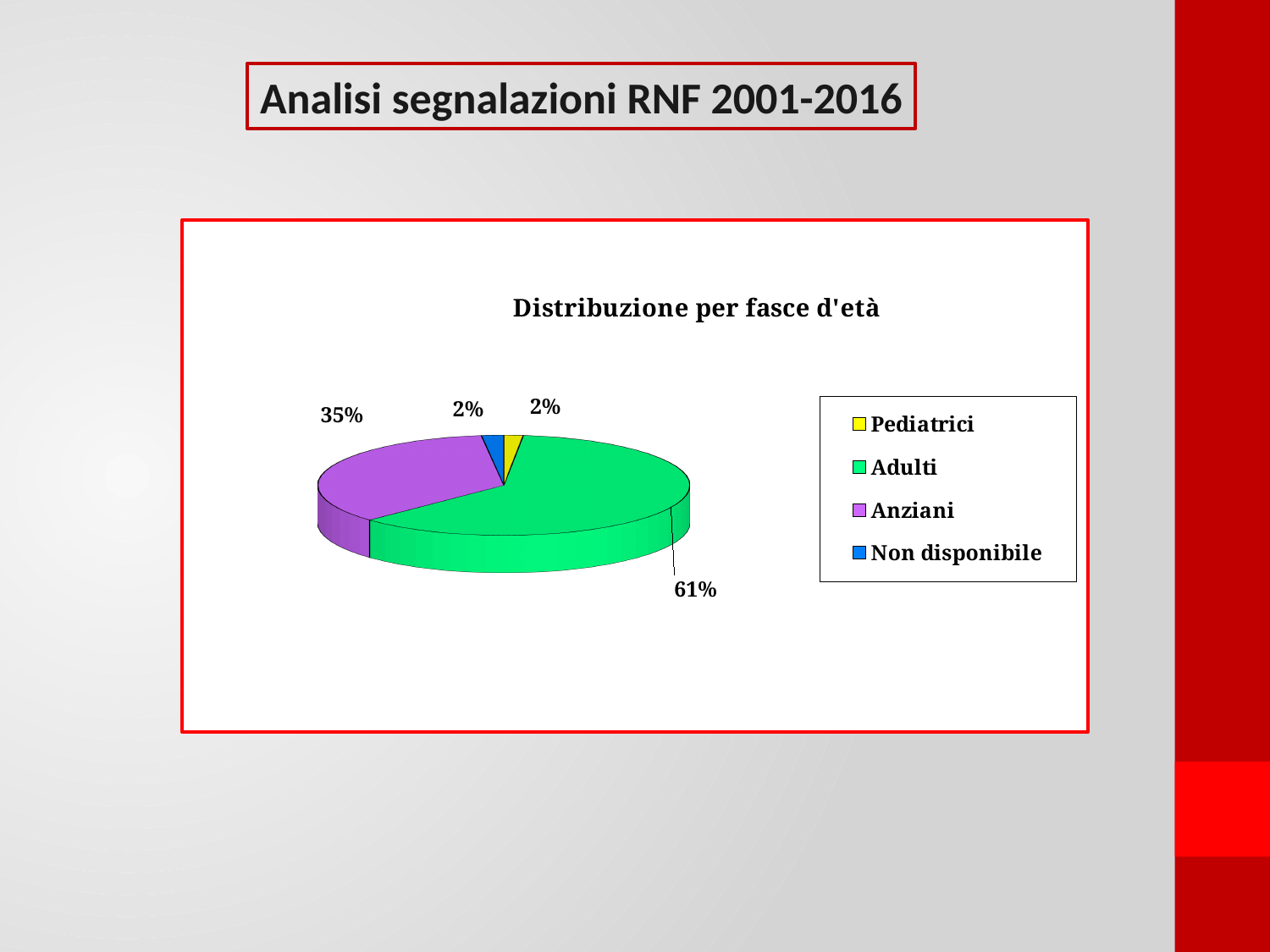
Which colour represents Anziani in the chart? purple Which category has the largest slice of the pie? Adulti What is the title of the chart? Distribuzione per fasce d'età What share of the pie does Non disponibile represent? 2% What is the combined share of Pediatrici and Non disponibile? 4% What kind of chart is shown on the slide? pie chart What is the difference between the Adulti share and the Anziani share? 26% Which is larger, the Anziani share or the Pediatrici share? Anziani How many categories does the legend list? 4 What share of the pie does Adulti represent? 61% What share of the pie does Pediatrici represent? 2%